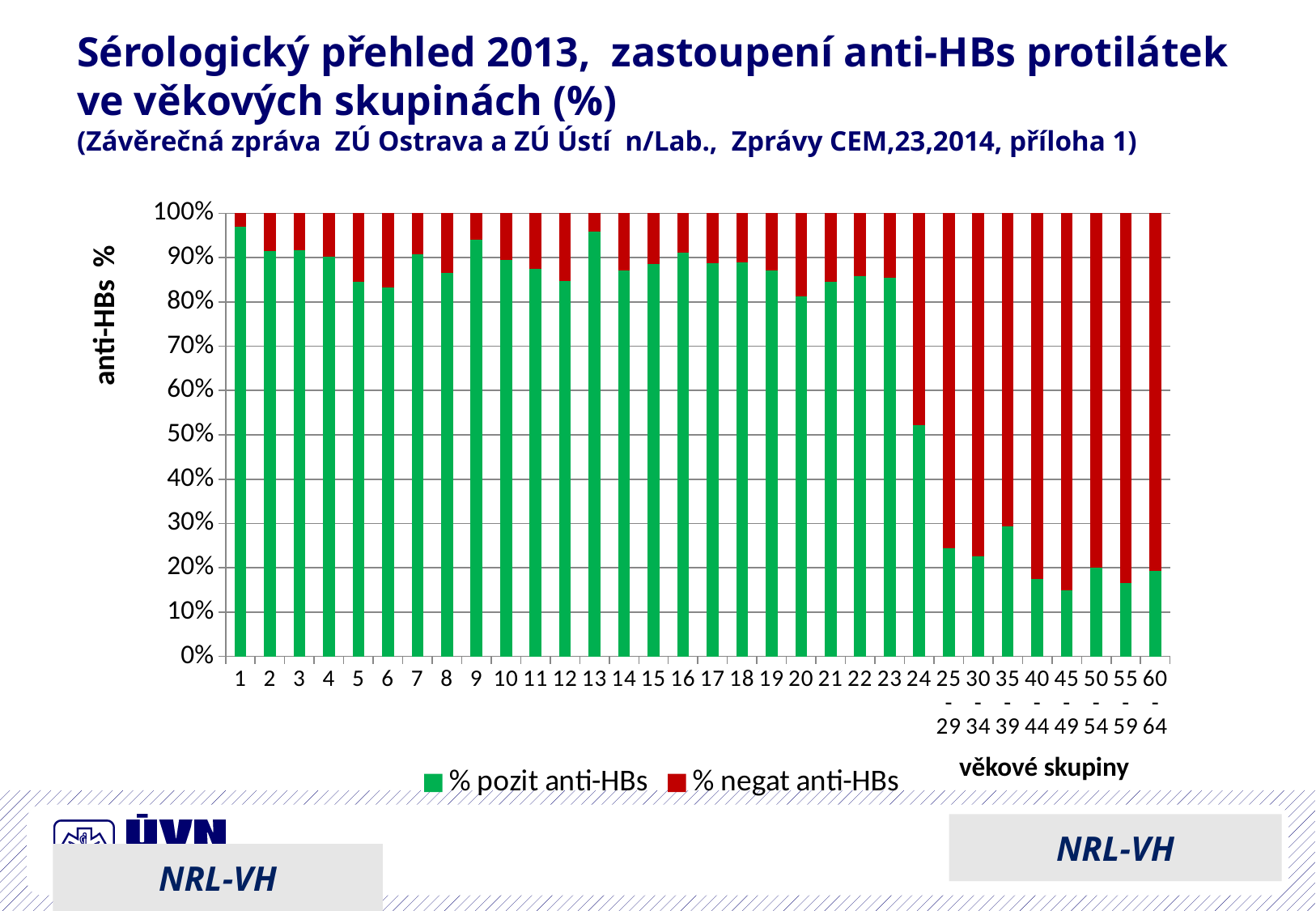
What kind of chart is shown on the slide? stacked bar chart Which series is shown in green? % pozit anti-HBs Is the % pozit anti-HBs value for age group 45-49 greater or less than 20%? less Is the % pozit anti-HBs value for age group 1 greater or less than 90%? greater Overall, does the share of % pozit anti-HBs rise or fall moving from the youngest to the oldest age groups? fall Which age group has the larger % negat anti-HBs value, 1 or 60-64? 60-64 What is the label of the y axis? anti-HBs % Is the % negat anti-HBs value for age group 40-44 greater or less than 80%? greater How many series does the legend list? 2 How many age-group categories are plotted along the x axis? 32 Which age group has the larger % pozit anti-HBs value, 24 or 25-29? 24